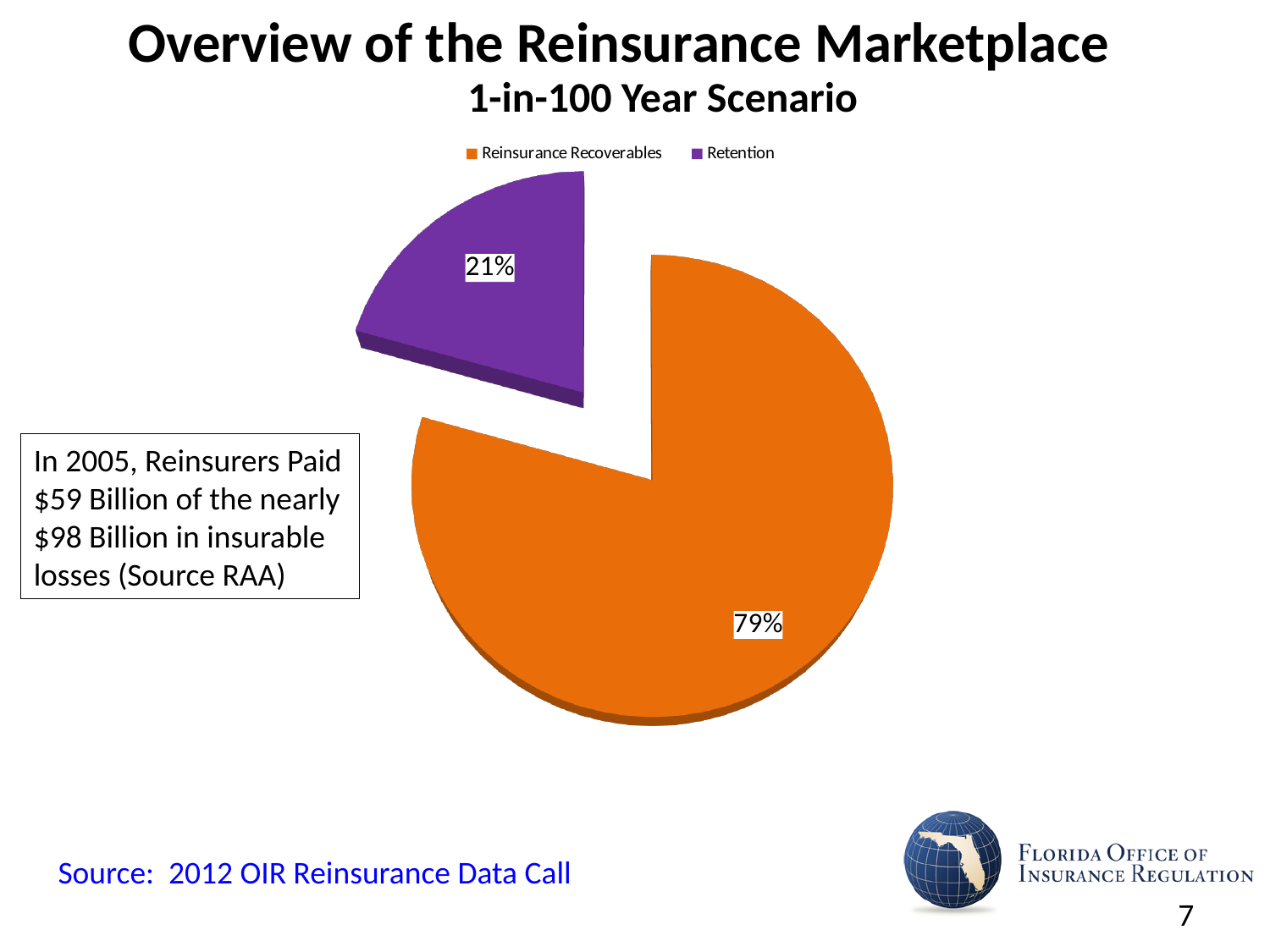
What kind of chart is shown on the slide? Pie chart Which slice of the pie is the largest? Reinsurance Recoverables What share of the pie is Reinsurance Recoverables? 79% Which is larger, the Retention slice or the Reinsurance Recoverables slice? Reinsurance Recoverables What share of the pie is Retention? 21% Which slice of the pie is the smallest? Retention What colour is the Retention slice? Purple What is the difference in percentage points between the Reinsurance Recoverables slice and the Retention slice? 58 How many entries does the chart legend list? 2 How many slices does the pie chart have? 2 What is the subtitle of the chart shown on the slide? 1-in-100 Year Scenario